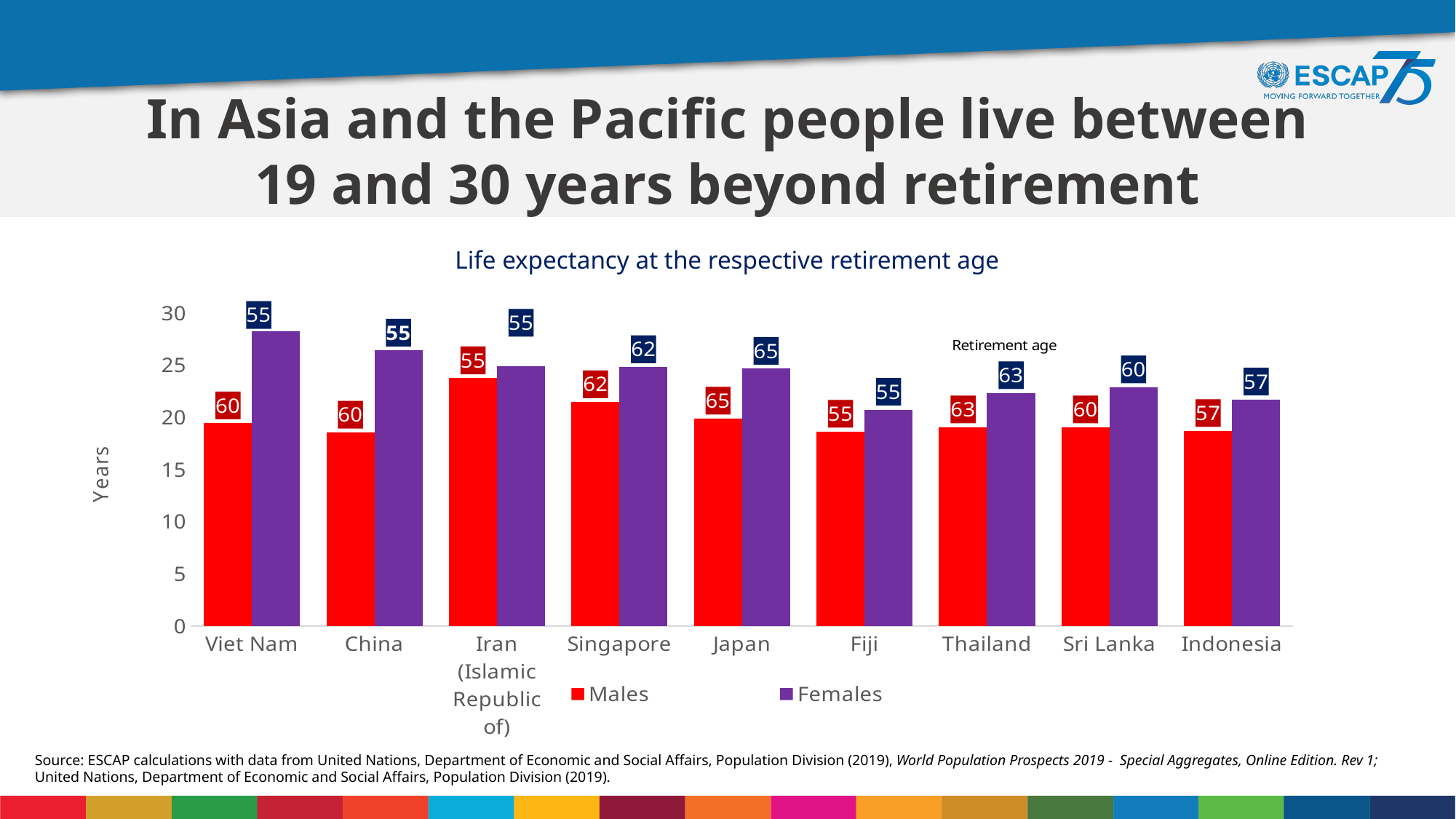
How many series does the chart legend list? 2 Which is larger, the Females value for Viet Nam or the Females value for China? Viet Nam What retirement age is printed on the Males bar for Japan? 65 What kind of chart is shown on the slide? bar chart Which is larger, the Males value for Iran (Islamic Republic of) or the Males value for Singapore? Iran (Islamic Republic of) Which country has the highest life expectancy at retirement age for Males? Iran (Islamic Republic of) How many countries are shown on the x axis of the chart? 9 Is the Males value for Fiji greater or less than 20? less Is the Females value for Sri Lanka greater or less than 25? less Which country has the highest life expectancy at retirement age for Females? Viet Nam Is the Females value for Viet Nam greater or less than 25? greater